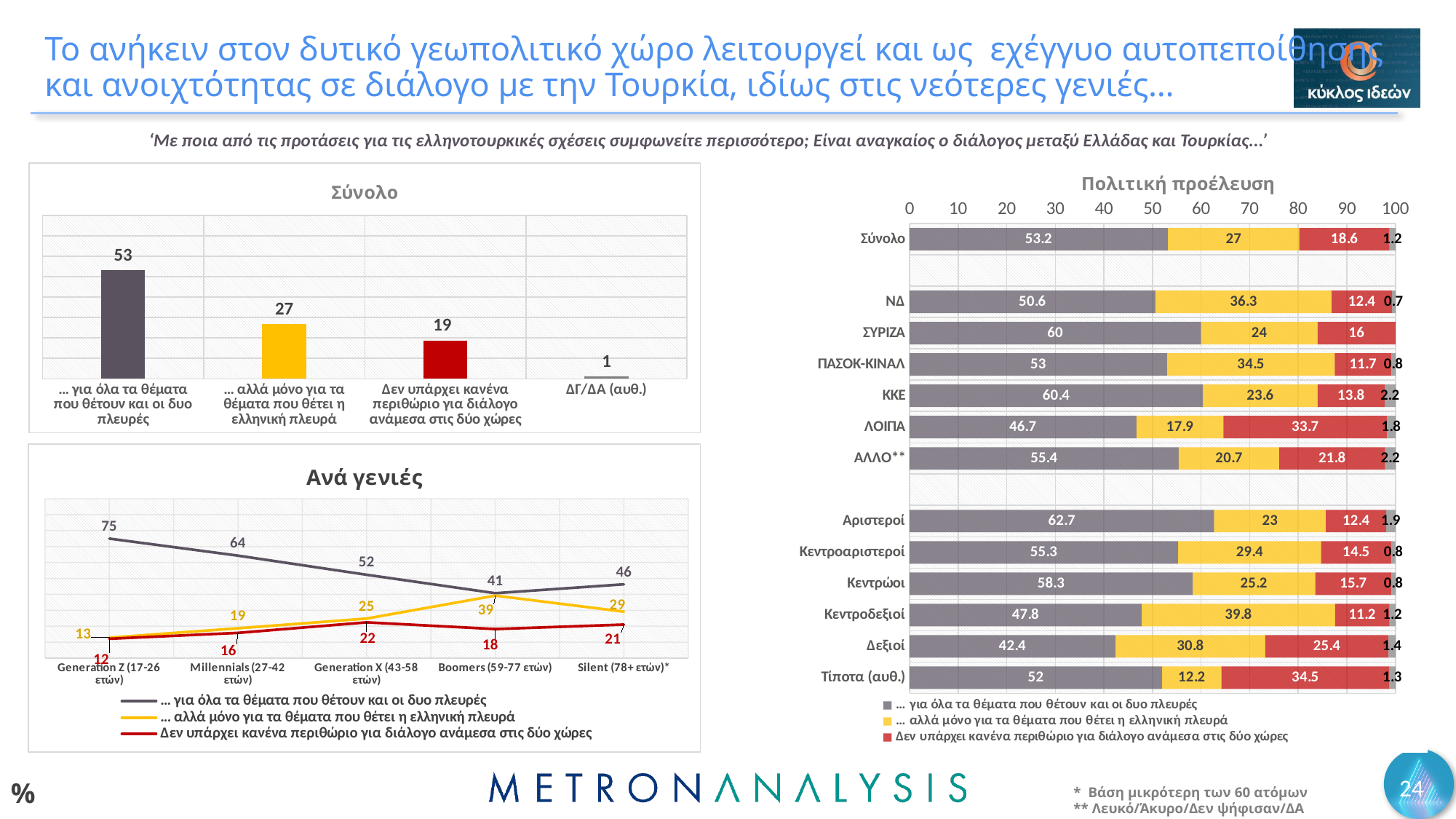
In the 'Πολιτική προέλευση' chart, what is the value of the '… για όλα τα θέματα που θέτουν και οι δυο πλευρές' segment for ΣΥΡΙΖΑ? 60 In the 'Σύνολο' chart, what is the difference between the values for '… αλλά μόνο για τα θέματα που θέτει η ελληνική πλευρά' and 'Δεν υπάρχει κανένα περιθώριο για διάλογο ανάμεσα στις δύο χώρες'? 8 In the 'Σύνολο' chart, what is the value for '… για όλα τα θέματα που θέτουν και οι δυο πλευρές'? 53 In the 'Σύνολο' chart, which category has the lowest value? ΔΓ/ΔΑ (αυθ.) In the 'Ανά γενιές' chart, what is the value of the '… για όλα τα θέματα που θέτουν και οι δυο πλευρές' series for Generation Z (17-26 ετών)? 75 What kind of chart is the 'Ανά γενιές' chart? Line chart In the 'Πολιτική προέλευση' chart, which category has the highest value for the 'Δεν υπάρχει κανένα περιθώριο για διάλογο ανάμεσα στις δύο χώρες' segment? Τίπoτα (αυθ.) What kind of chart is the 'Πολιτική προέλευση' chart? Stacked bar chart In the 'Ανά γενιές' chart, does the '… για όλα τα θέματα που θέτουν και οι δυο πλευρές' series rise or fall from Generation Z to Boomers? Fall In the 'Ανά γενιές' chart, how many series does the legend list? 3 In the 'Ανά γενιές' chart, for Boomers (59-77 ετών), which is larger: the '… αλλά μόνο για τα θέματα που θέτει η ελληνική πλευρά' series or the 'Δεν υπάρχει κανένα περιθώριο για διάλογο ανάμεσα στις δύο χώρες' series? … αλλά μόνο για τα θέματα που θέτει η ελληνική πλευρά In the 'Πολιτική προέλευση' chart, what is the difference between the '… αλλά μόνο για τα θέματα που θέτει η ελληνική πλευρά' values for Κεντροδεξιοί and Δεξιοί? 9